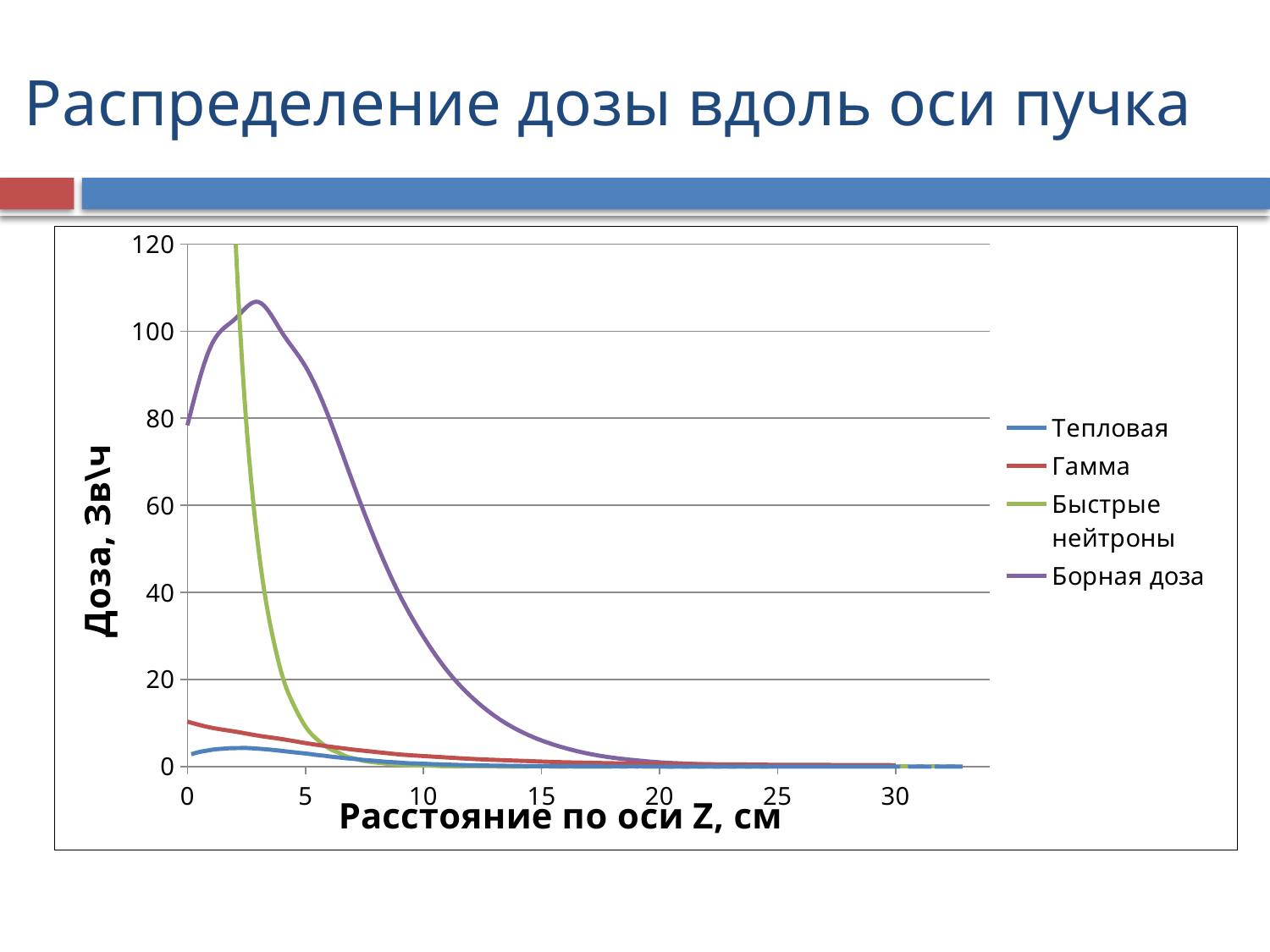
Is the value of Борная доза at Z = 10 см greater or less than 20? greater Does the Гамма series rise or fall as the distance along the Z axis increases? fall Is the peak value of Борная доза greater or less than 100? greater What kind of chart is shown on the slide? line chart What is the title of the slide's chart? Распределение дозы вдоль оси пучка What is the label of the vertical axis? Доза, Зв\ч Is the value of Быстрые нейтроны at Z = 5 см greater or less than 20? less At Z = 10 см, which is larger: Борная доза or Гамма? Борная доза At Z = 0, which is larger: Гамма or Тепловая? Гамма How many series does the legend list? 4 Which series reaches the highest dose value on the chart? Быстрые нейтроны